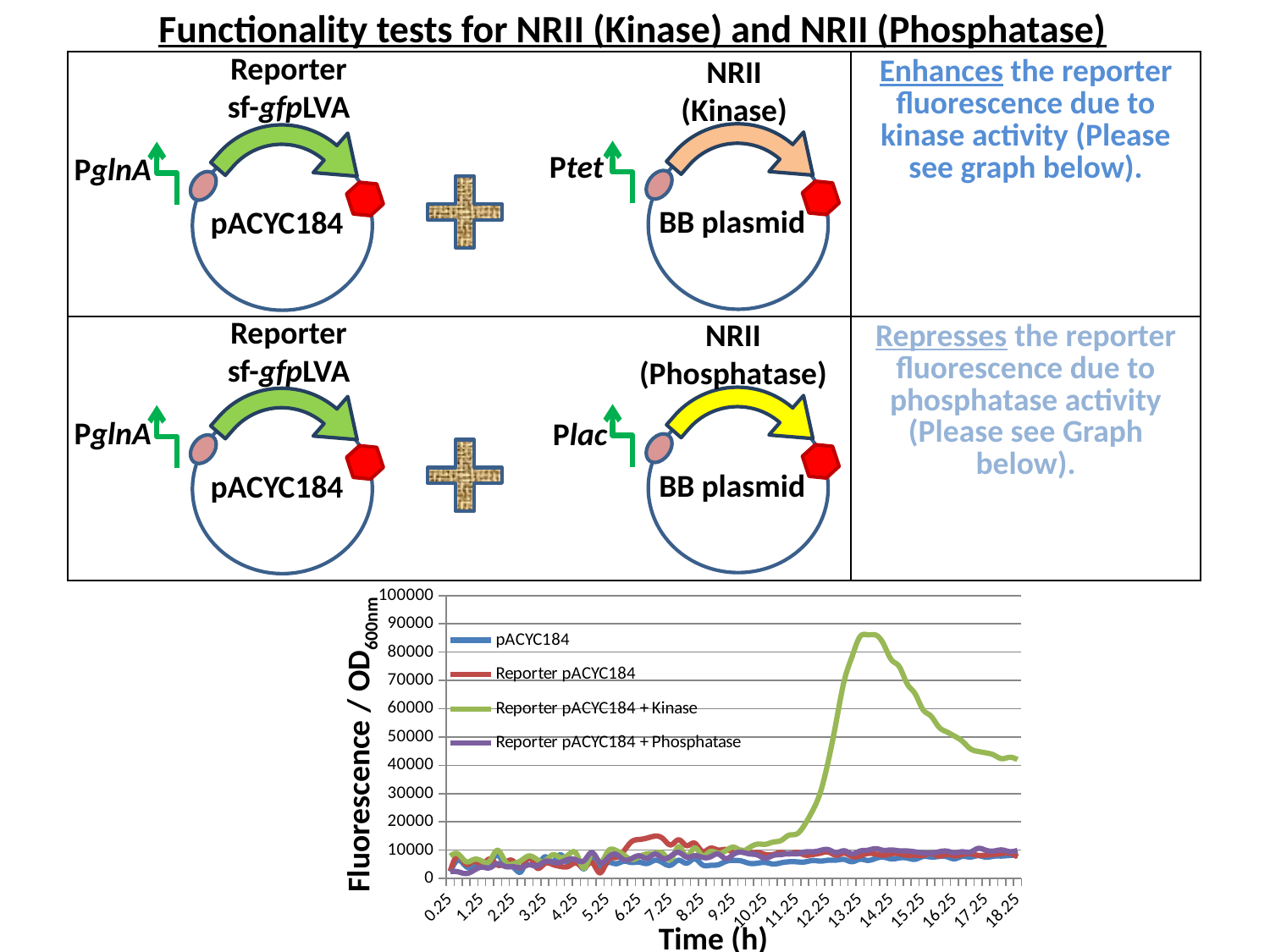
At 13.25 h, which series has the larger value: Reporter pACYC184 + Kinase or pACYC184? Reporter pACYC184 + Kinase What is the highest value shown on the y axis of the chart? 100000 Is the value of the Reporter pACYC184 + Kinase series at 18.25 h greater or less than 50000? less What is the label of the x axis of the chart? Time (h) Is the value of the Reporter pACYC184 + Phosphatase series at 13.25 h greater or less than 20000? less Does the Reporter pACYC184 + Kinase series rise or fall between 11.25 h and 13.25 h? rise Which series in the chart reaches the highest fluorescence value? Reporter pACYC184 + Kinase How many series does the legend of the chart list? 4 Does the Reporter pACYC184 + Kinase series rise or fall between 13.25 h and 18.25 h? fall What kind of chart is shown at the bottom of the slide? line chart Is the peak value of the Reporter pACYC184 + Kinase series greater or less than 80000? greater